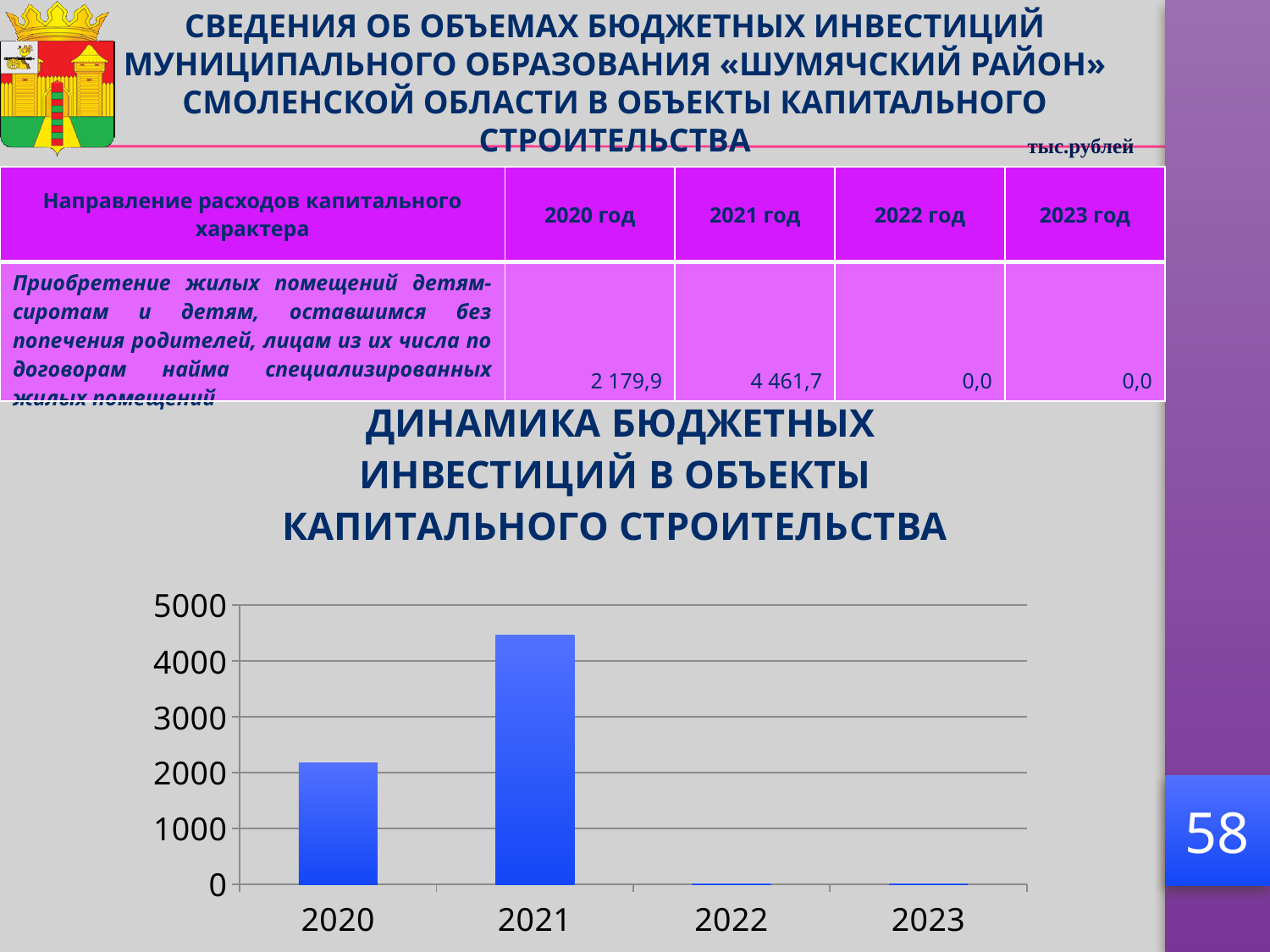
According to the table on the slide, what is the value for 2020 (тыс. рублей)? 2 179,9 Is the value for 2020 greater or less than 2000? greater Which year has the highest bar in the chart? 2021 What is the highest tick value shown on the vertical axis of the chart? 5000 What is the title of the chart? ДИНАМИКА БЮДЖЕТНЫХ ИНВЕСТИЦИЙ В ОБЪЕКТЫ КАПИТАЛЬНОГО СТРОИТЕЛЬСТВА What is the value for 2022 in the chart? 0 Is the value for 2020 greater or less than 3000? less Which is larger, the value for 2020 or the value for 2021? 2021 How many years are shown on the x axis of the chart? 4 What kind of chart is shown on the slide? bar chart According to the table on the slide, what is the value for 2021 (тыс. рублей)? 4 461,7 Is the value for 2021 greater or less than 4000? greater